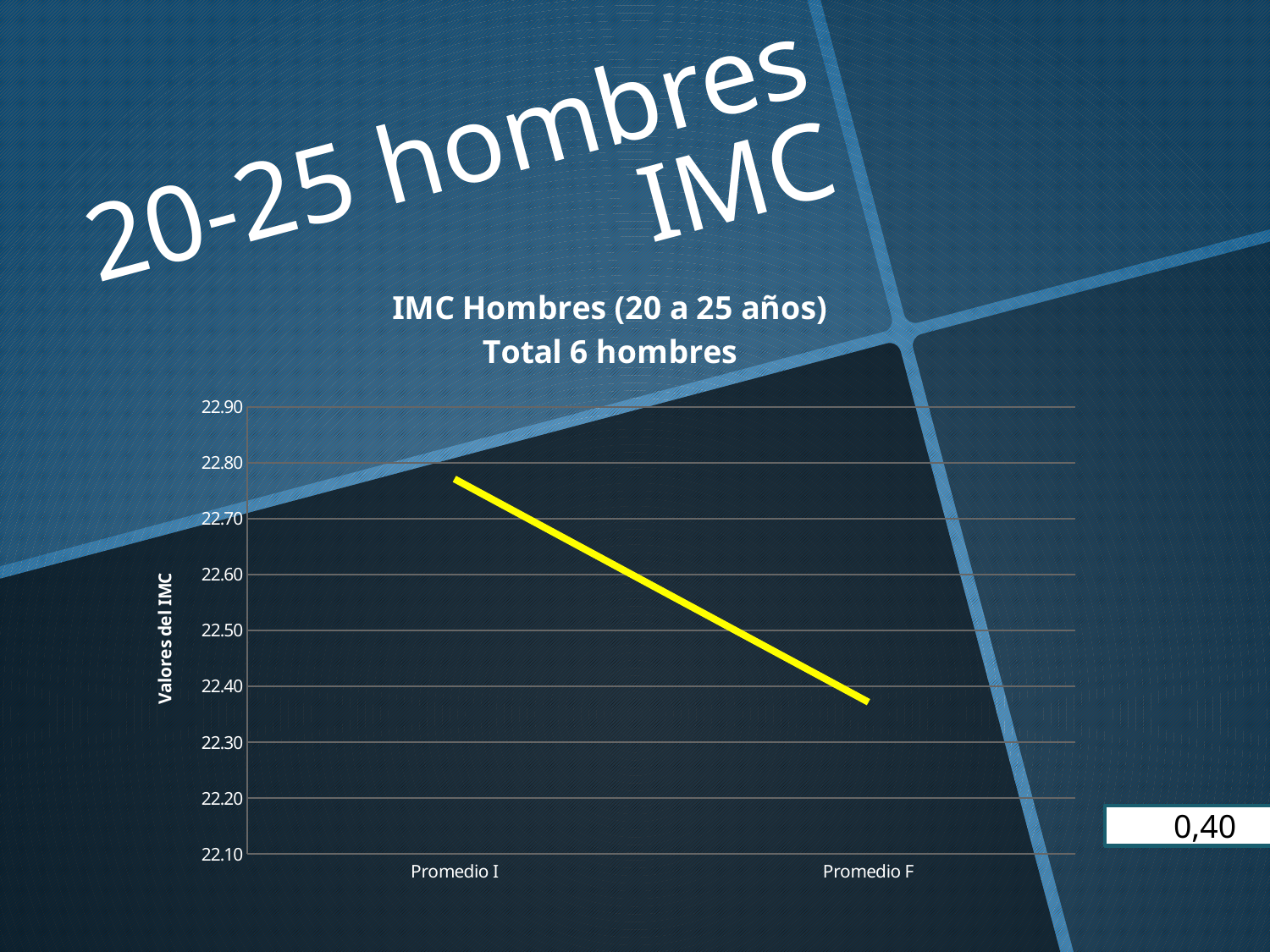
What is the title of the chart? IMC Hombres (20 a 25 años) Total 6 hombres Is the value for Promedio F greater or less than 22.50? less Do the values rise or fall from Promedio I to Promedio F? fall Is the value for Promedio I greater or less than 22.70? greater Which category has the lowest value? Promedio F Is the value for Promedio F greater or less than 22.30? greater Which category has the highest value? Promedio I Which category has the higher value, Promedio I or Promedio F? Promedio I How many categories are shown on the x axis? 2 What is the label of the vertical axis? Valores del IMC What kind of chart is shown on the slide? line chart